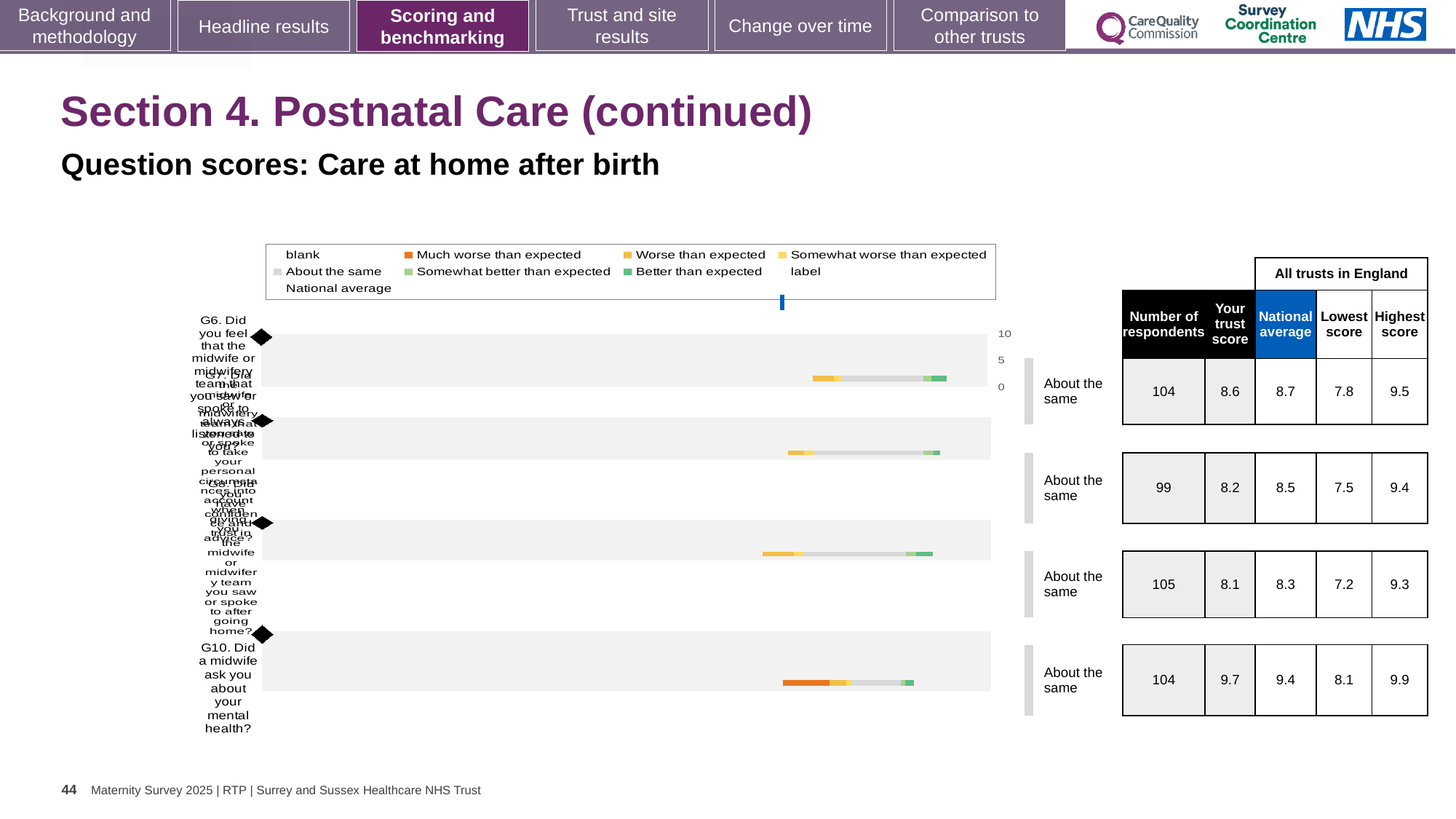
What benchmark category label is shown for all four question rows? About the same For the first row (G6), which is larger: the trust score or the national average? National average What is the trust score for G10 (Did a midwife ask you about your mental health?)? 9.7 What colour does the legend use for 'Much worse than expected'? Orange How many question rows (bars) are plotted in the chart? 4 What kind of chart is shown on the slide? bar chart What is the lowest trust score shown among the four rows? 8.1 Which question row has the highest trust score? G10 What is the highest score across all trusts in England for G10? 9.9 What is the national average for G10 (Did a midwife ask you about your mental health?)? 9.4 How many respondents are shown for the first row (G6)? 104 By how much does the trust score for G10 exceed its national average? 0.3